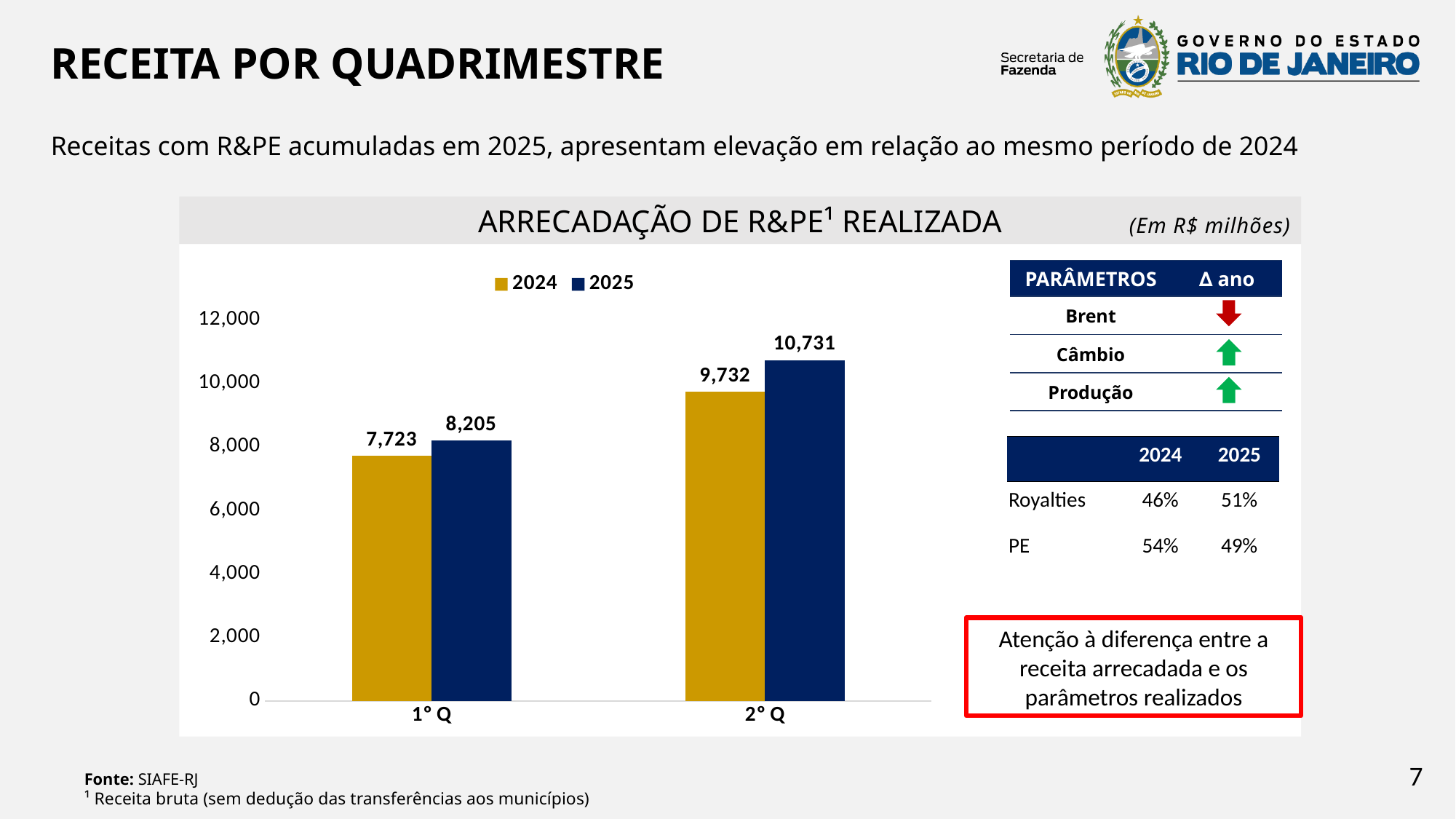
How many series does the legend list? 2 What is the value for 2025 in 1° Q? 8,205 Which bar has the highest value in the chart? 2025 in 2° Q What is the value for 2025 in 2° Q? 10,731 What kind of chart is shown on the slide? Bar chart What is the value for 2024 in 1° Q? 7,723 What is the title of the chart? ARRECADAÇÃO DE R&PE¹ REALIZADA What is the value for 2024 in 2° Q? 9,732 What is the difference between the 2025 and 2024 values in 1° Q? 482 What is the difference between the 2025 and 2024 values in 2° Q? 999 Which is larger in 1° Q, the 2024 value or the 2025 value? 2025 Which bar has the lowest value in the chart? 2024 in 1° Q